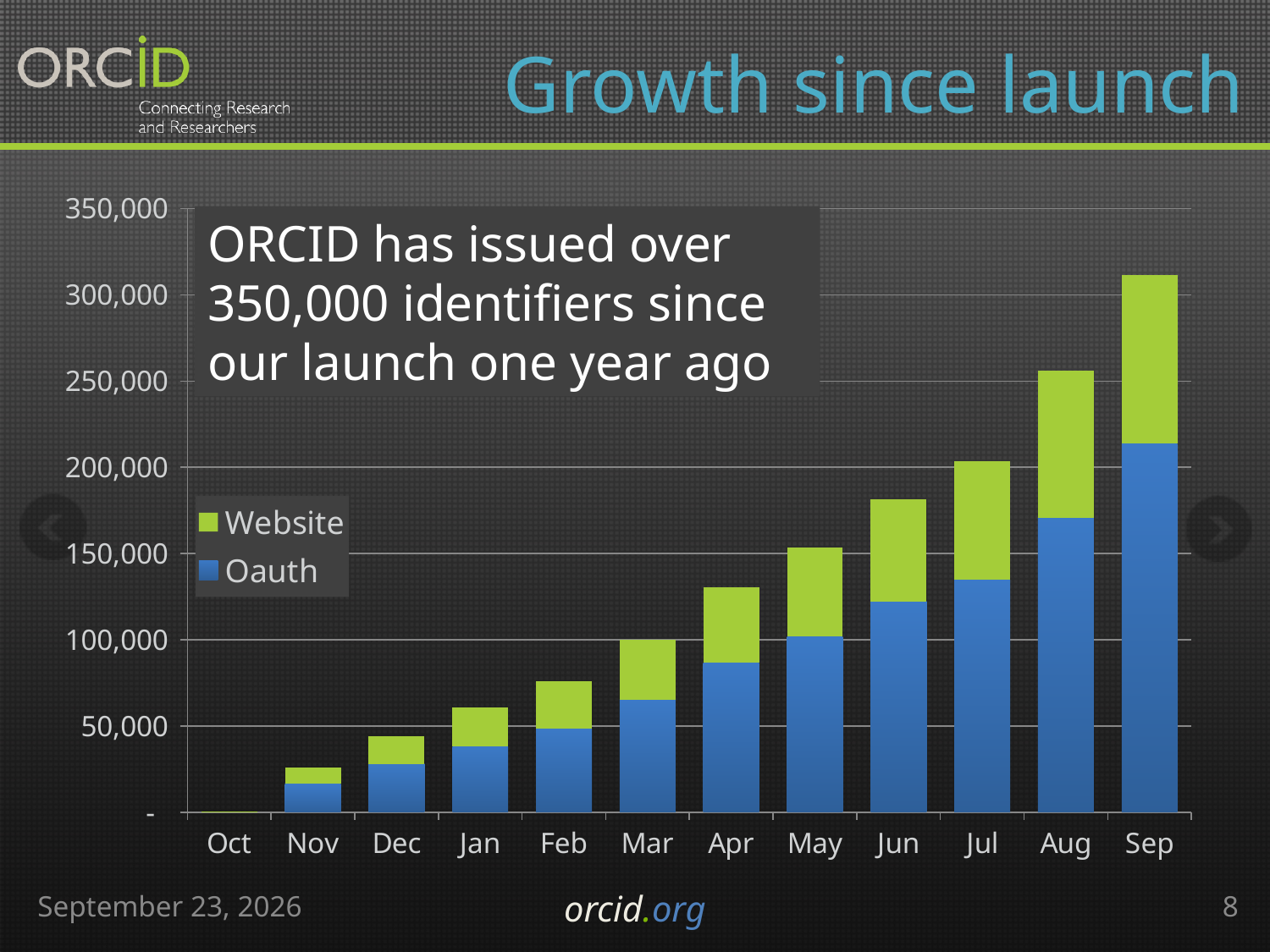
Is the total for Sep greater or less than 300,000? greater How many series does the legend list? 2 Which month has the smallest total? Oct What kind of chart is shown on the slide? Stacked bar chart Do the stacked totals rise or fall from Oct to Sep? Rise Which month has the tallest stacked bar? Sep How many months are shown along the x axis? 12 Is the total for Nov greater or less than 50,000? less Is the Oauth value for Sep greater or less than 200,000? greater Which colour represents the Website series in the legend? Green Which month has the larger total, Aug or Jul? Aug